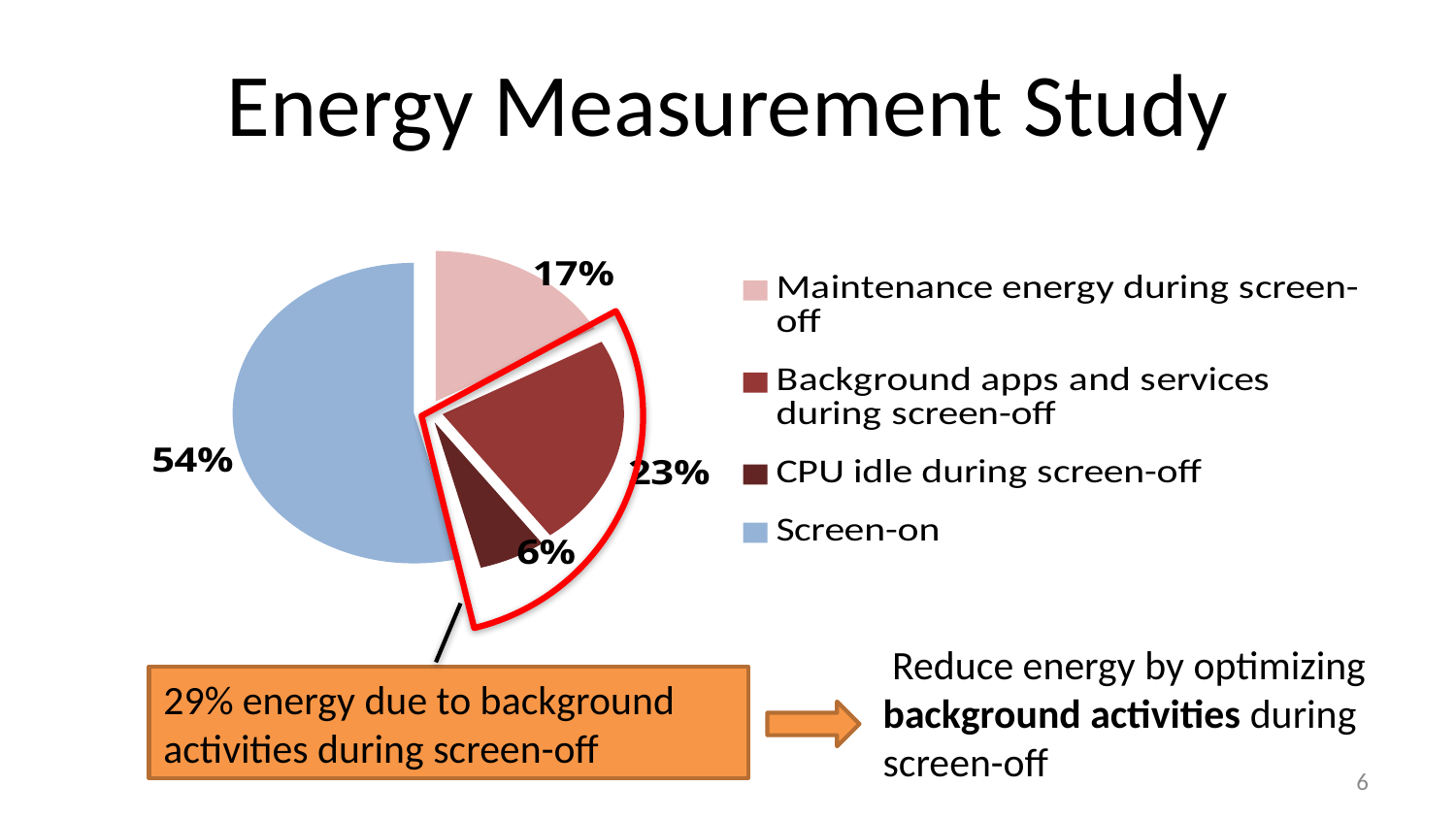
What percentage of energy is attributed to Screen-on? 54% What percentage of energy is attributed to Maintenance energy during screen-off? 17% What percentage of energy is attributed to Background apps and services during screen-off? 23% What is the difference in percentage points between Screen-on and Background apps and services during screen-off? 31 Which is larger, the share for Maintenance energy during screen-off or the share for CPU idle during screen-off? Maintenance energy during screen-off What percentage of energy is attributed to CPU idle during screen-off? 6% Which category has the smallest share of the pie? CPU idle during screen-off Which category has the largest share of the pie? Screen-on How many slices does the pie chart have? 4 What colour is the Screen-on slice in the pie chart? light blue What kind of chart is shown on the slide? pie chart How many entries does the legend list? 4